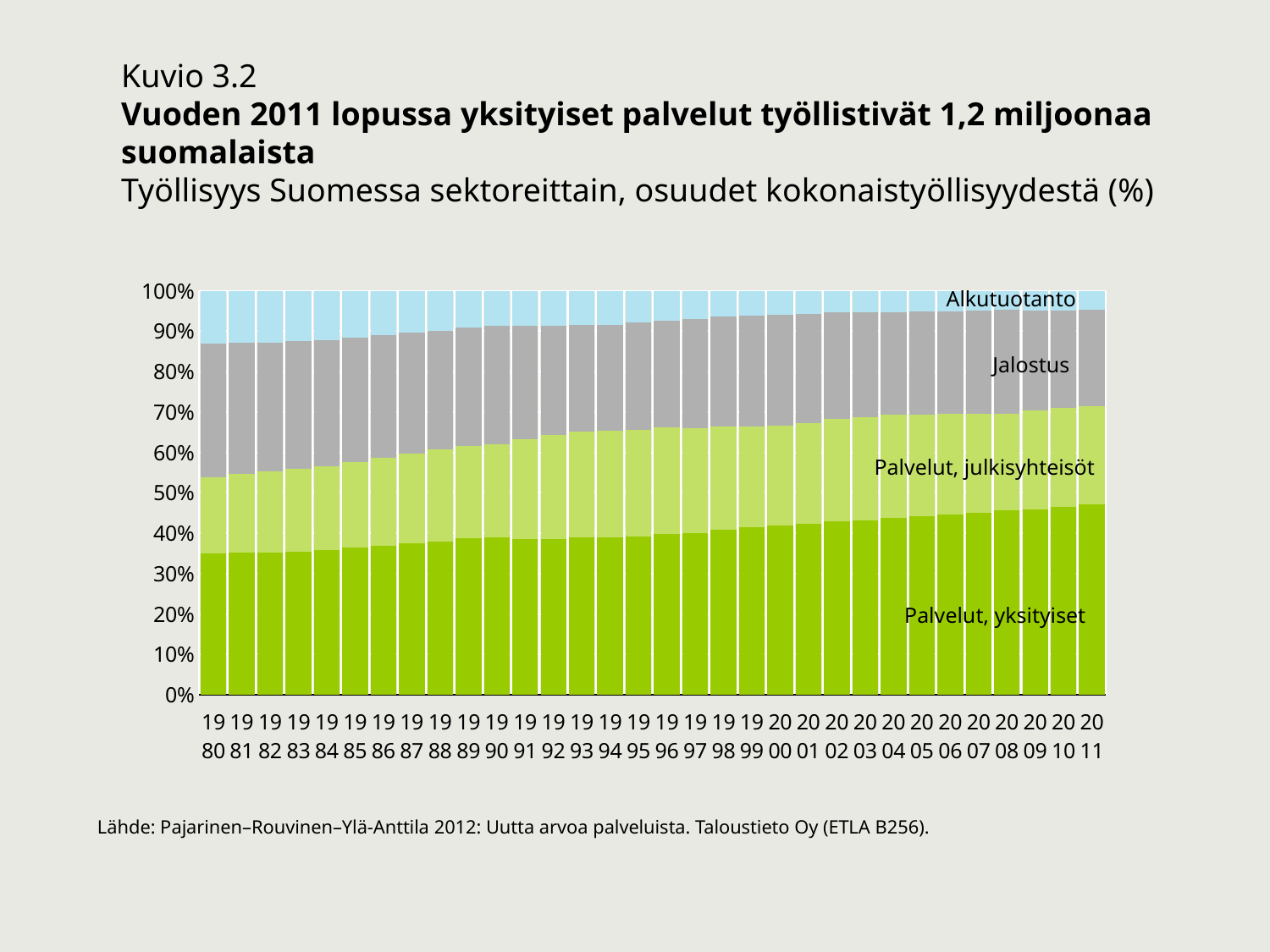
Which sector has the largest share of employment in 2011? Palvelut, yksityiset Does the share of Palvelut, yksityiset rise or fall from 1980 to 2011? Rise How many sectors (series) are shown in the chart? 4 In 2011, which sector has the larger share: Palvelut, yksityiset or Alkutuotanto? Palvelut, yksityiset What kind of chart is shown on the slide? Stacked bar chart What is the subtitle describing what the chart shows? Työllisyys Suomessa sektoreittain, osuudet kokonaistyöllisyydestä (%) Which sector has the smallest share of employment in 2011? Alkutuotanto Does the share of Jalostus rise or fall from 1980 to 2011? Fall How many years are plotted along the x axis? 32 Is the share of Palvelut, yksityiset in 1980 greater or less than 40%? less Is the share of Alkutuotanto in 2011 greater or less than 10%? less Is the share of Palvelut, yksityiset in 2011 greater or less than 40%? greater